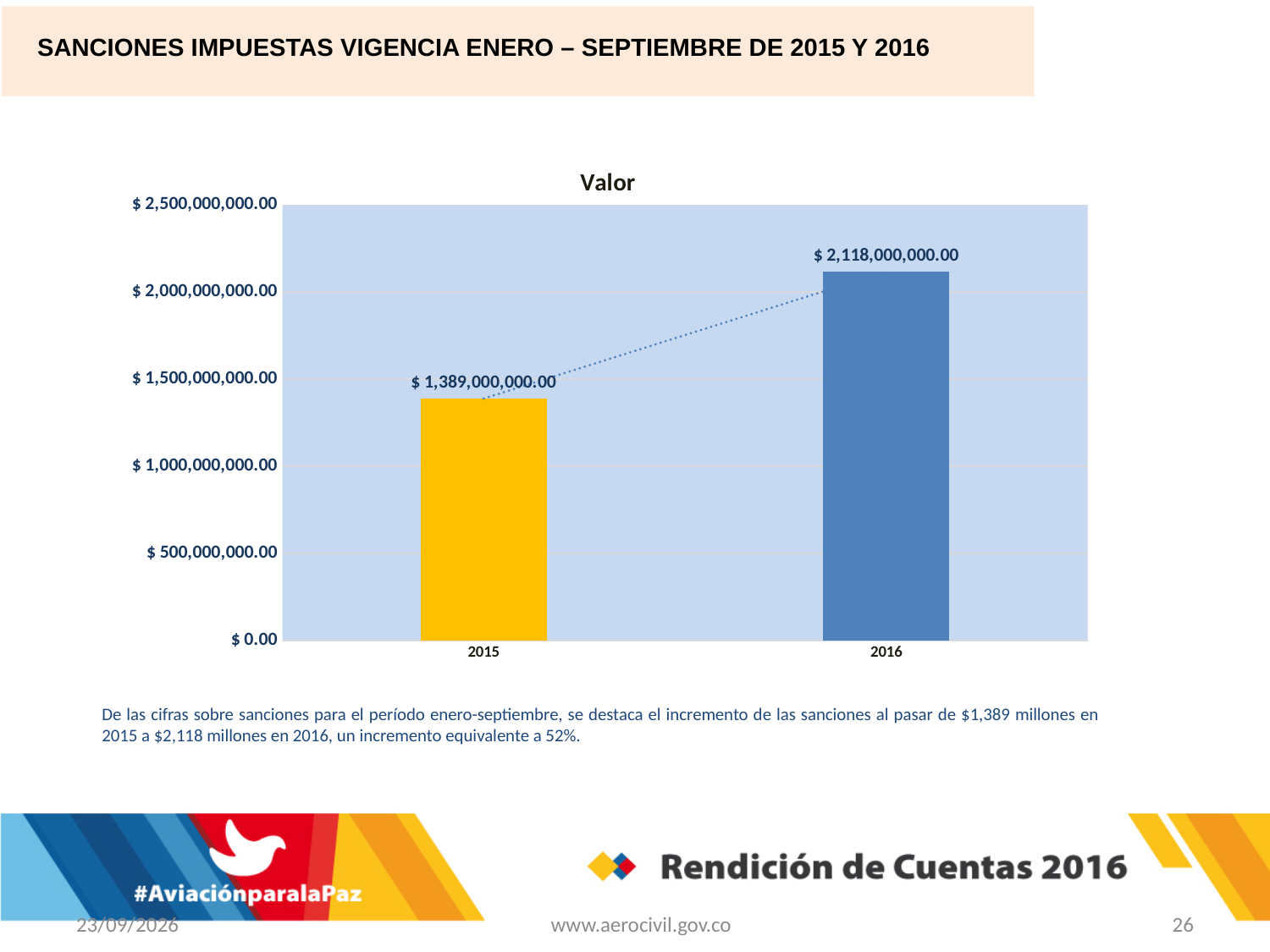
Which year has the higher value? 2016 What is the value for 2016? $ 2,118,000,000.00 What is the value for 2015? $ 1,389,000,000.00 Is the value for 2015 larger or smaller than the value for 2016? smaller What is the difference between the 2016 and 2015 values? $ 729,000,000.00 Is the value for 2016 greater or less than $ 2,000,000,000.00? greater Is the value for 2015 greater or less than $ 1,500,000,000.00? less What is the title of the chart? Valor Do the values rise or fall from 2015 to 2016? rise Which year has the lower value? 2015 What kind of chart is shown? bar chart How many categories are shown on the x axis? 2